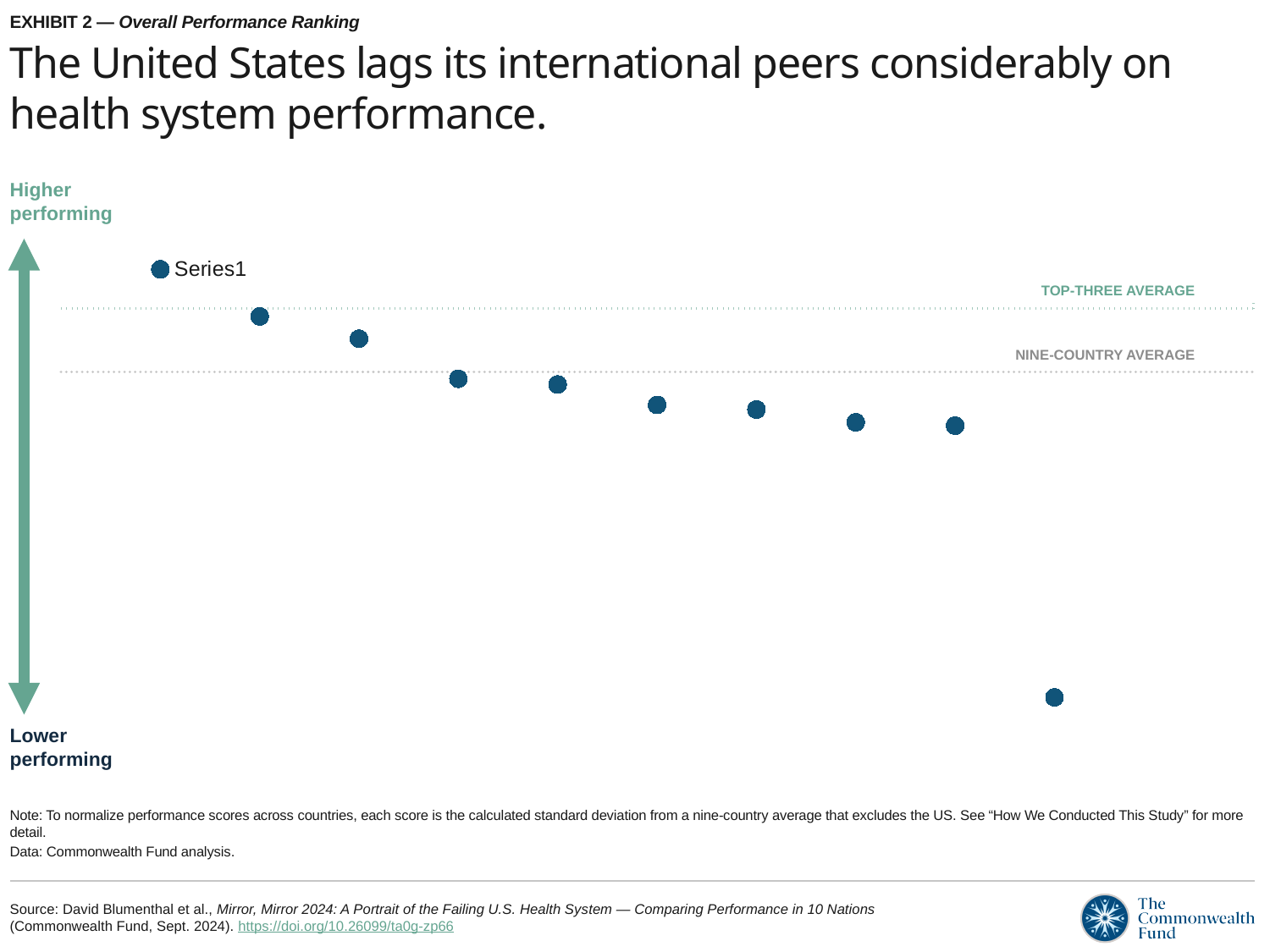
What are the two dotted reference lines on the chart labelled? TOP-THREE AVERAGE and NINE-COUNTRY AVERAGE Which point is the lowest performing: the leftmost or the rightmost? The rightmost Which is higher on the chart, the leftmost point or the rightmost point? The leftmost point What kind of chart is shown on the slide? Scatter (dot) chart Do the plotted values rise or fall moving from left to right along the x axis? Fall Is the rightmost point above or below the NINE-COUNTRY AVERAGE line? Below Is the second point from the left above or below the TOP-THREE AVERAGE line? Below